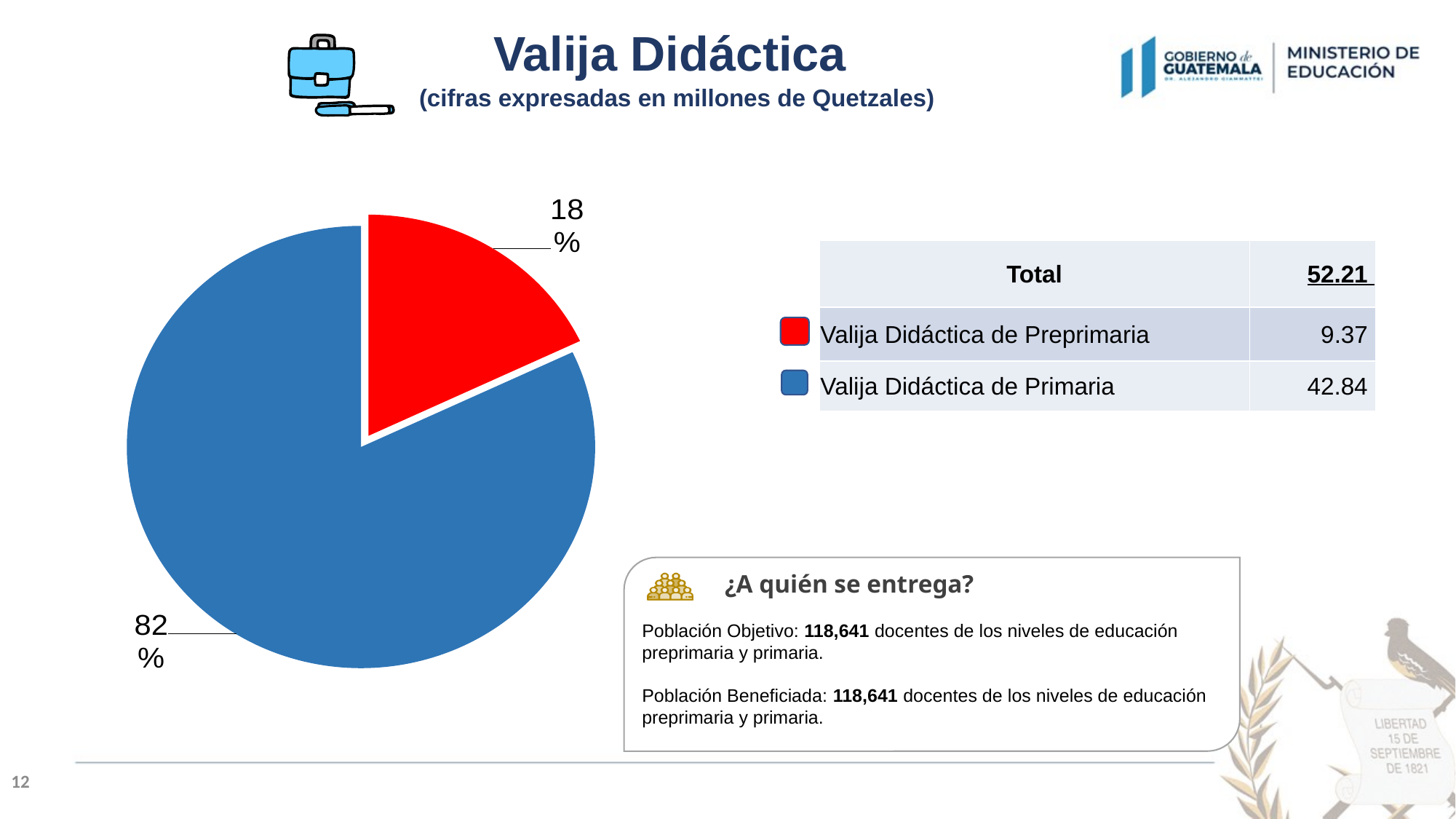
What is the difference between the values for Valija Didáctica de Primaria and Valija Didáctica de Preprimaria? 33.47 What is the total shown for Valija Didáctica? 52.21 What kind of chart is shown on the slide? pie chart Which category has the smallest slice of the pie? Valija Didáctica de Preprimaria Which category has the largest slice of the pie? Valija Didáctica de Primaria How many slices does the pie chart have? 2 What share of the pie does Valija Didáctica de Primaria represent? 82% What colour is the slice for Valija Didáctica de Preprimaria? red What share of the pie does Valija Didáctica de Preprimaria represent? 18% Which is larger, the value for Valija Didáctica de Preprimaria or Valija Didáctica de Primaria? Valija Didáctica de Primaria What is the value for Valija Didáctica de Primaria? 42.84 What is the value for Valija Didáctica de Preprimaria? 9.37